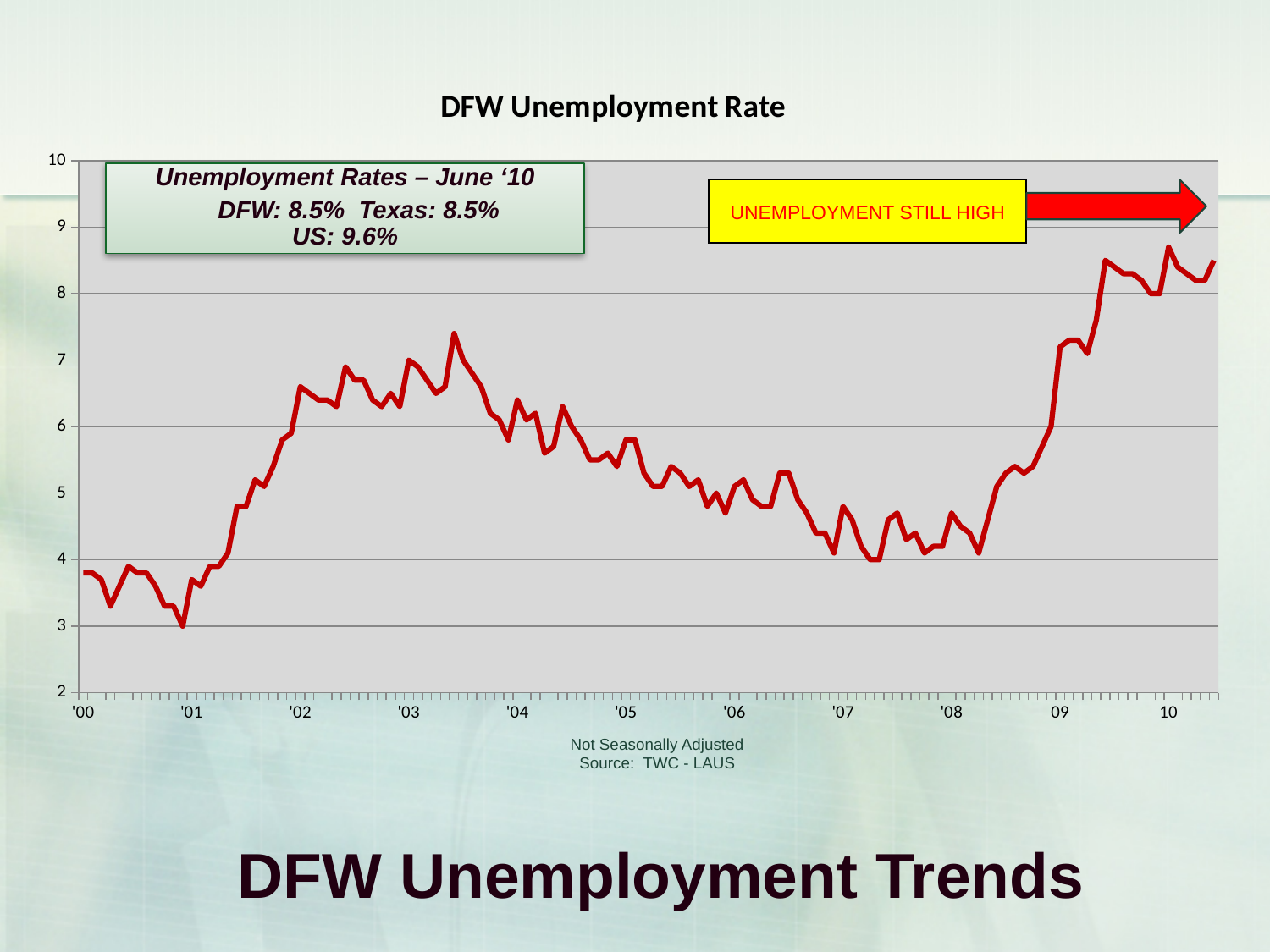
Does the DFW unemployment rate rise or fall between '08 and '10? rise What is the title of the chart? DFW Unemployment Rate By how many percentage points did the US unemployment rate exceed the DFW rate in June '10? 1.1 In June '10, which was higher, the US unemployment rate or the DFW unemployment rate? US What kind of chart is shown on the slide? line chart Is the DFW unemployment rate at the start of '01 greater or less than 4? less According to the text box, what was the US unemployment rate in June '10? 9.6% What source is cited below the chart? TWC - LAUS Is the DFW unemployment rate at the start of '07 greater or less than 5? less In which year on the x axis does the DFW unemployment rate reach its highest level? 10 According to the text box, what was the DFW unemployment rate in June '10? 8.5% Is the DFW unemployment rate at the start of '10 greater or less than 8? greater